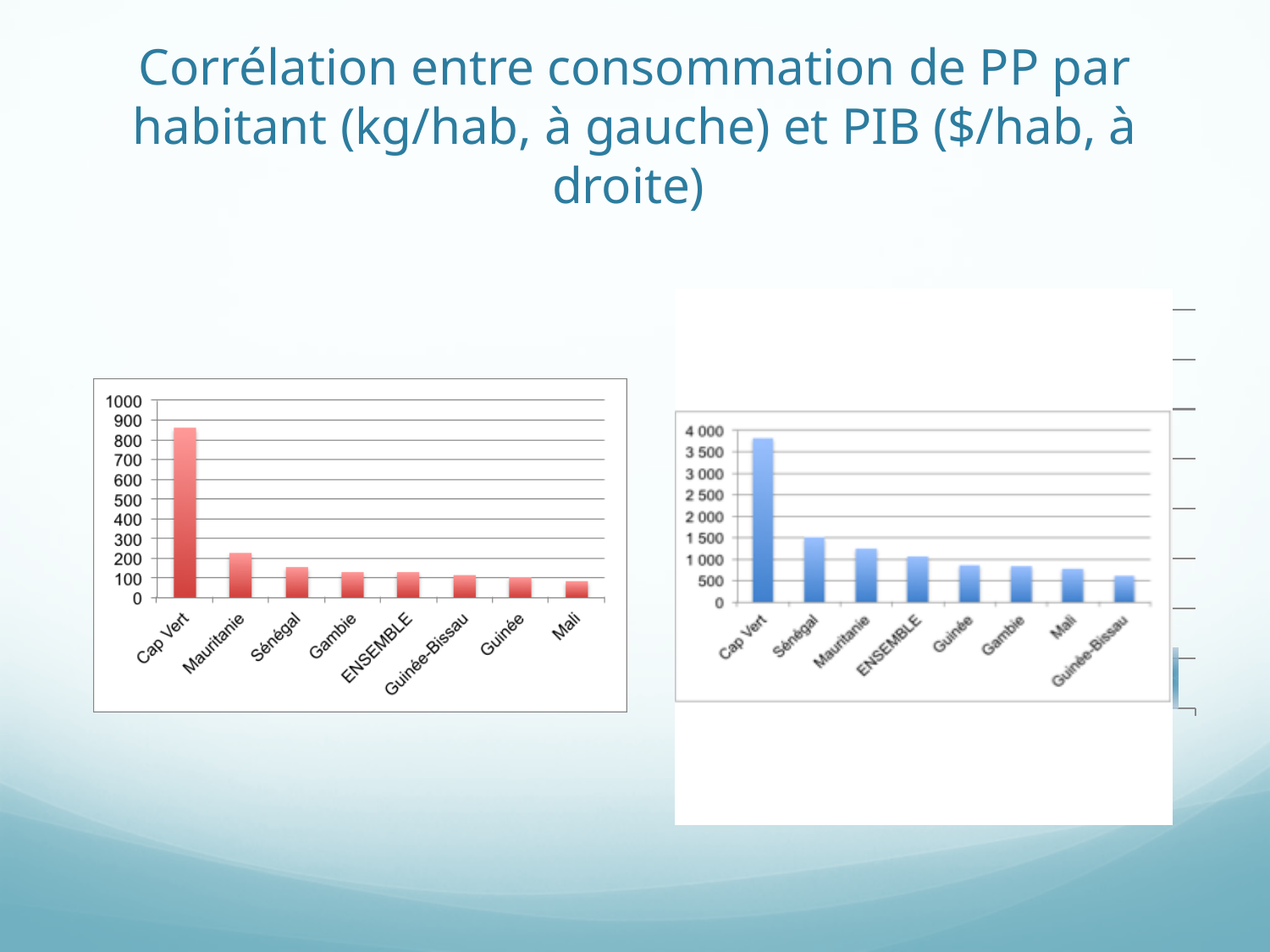
On the left chart (kg/hab), which is larger, the value for Mauritanie or the value for Sénégal? Mauritanie On the right chart (PIB $/hab), which category has the highest value? Cap Vert On the left chart (kg/hab), is the value for Mauritanie greater or less than 300? less On the left chart (kg/hab), is the value for Cap Vert greater or less than 800? greater On the left chart (kg/hab), which category has the highest value? Cap Vert How many countries/categories are shown on the left chart (kg/hab)? 8 On the right chart (PIB $/hab), is the value for Cap Vert greater or less than 3 500? greater On the right chart (PIB $/hab), which category has the lowest value? Guinée-Bissau On the right chart (PIB $/hab), do the values rise or fall from left to right along the x axis? fall What colour are the bars on the right chart (PIB $/hab)? blue On the left chart (kg/hab), which category has the lowest value? Mali What kind of chart is the left chart (consumption of PP per inhabitant)? bar chart